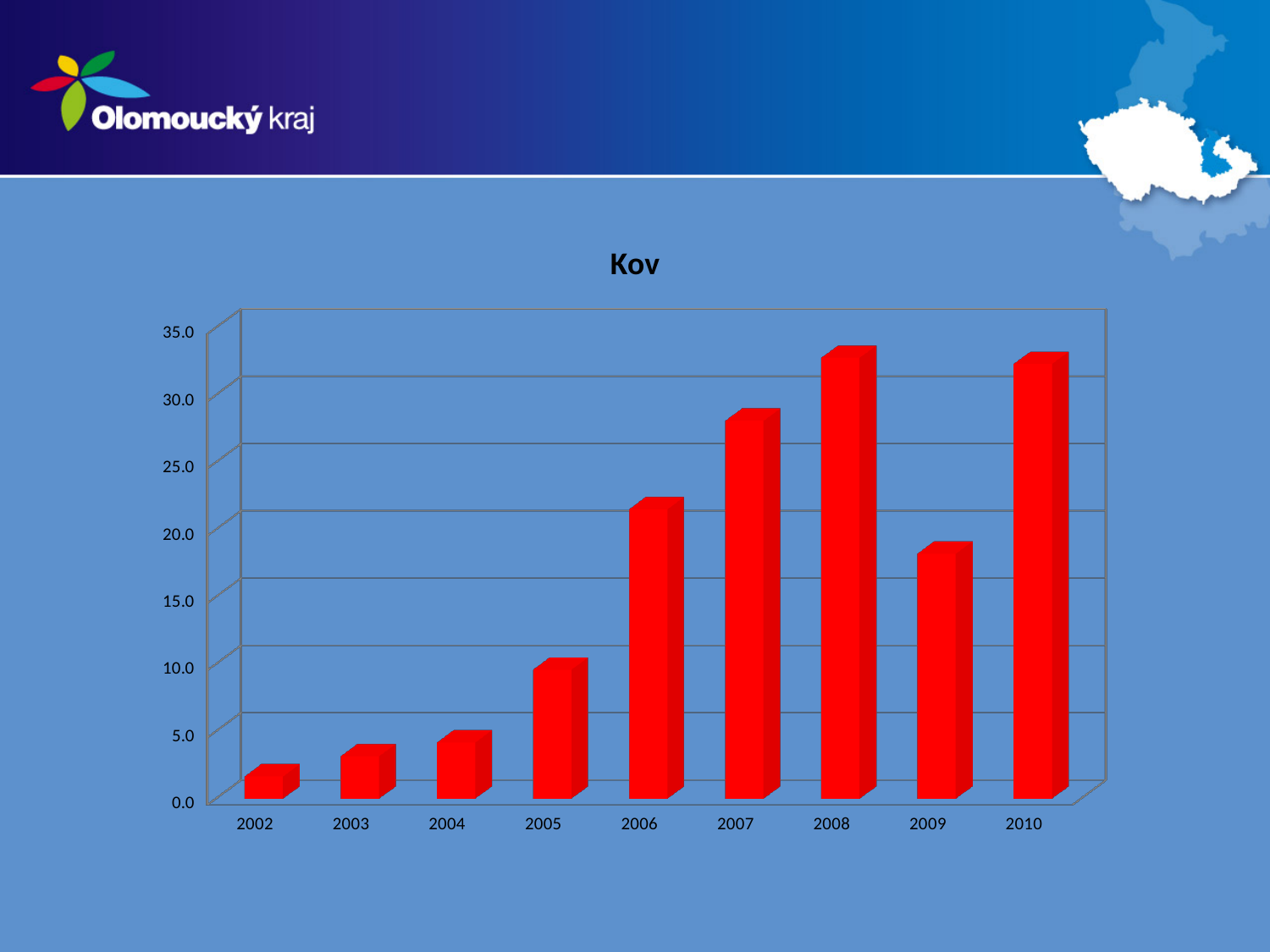
Is the value for 2003 greater or less than 5.0? less Is the value for 2008 greater or less than 30.0? greater Which is larger, the value for 2005 or the value for 2006? 2006 Which is larger, the value for 2007 or the value for 2009? 2007 Is the value for 2009 greater or less than 20.0? less Which year has the lowest value in the chart? 2002 What is the title of the chart? Kov What kind of chart is shown on the slide? bar chart How many years are shown on the x axis of the chart? 9 Do the values generally rise or fall from 2002 to 2008? rise